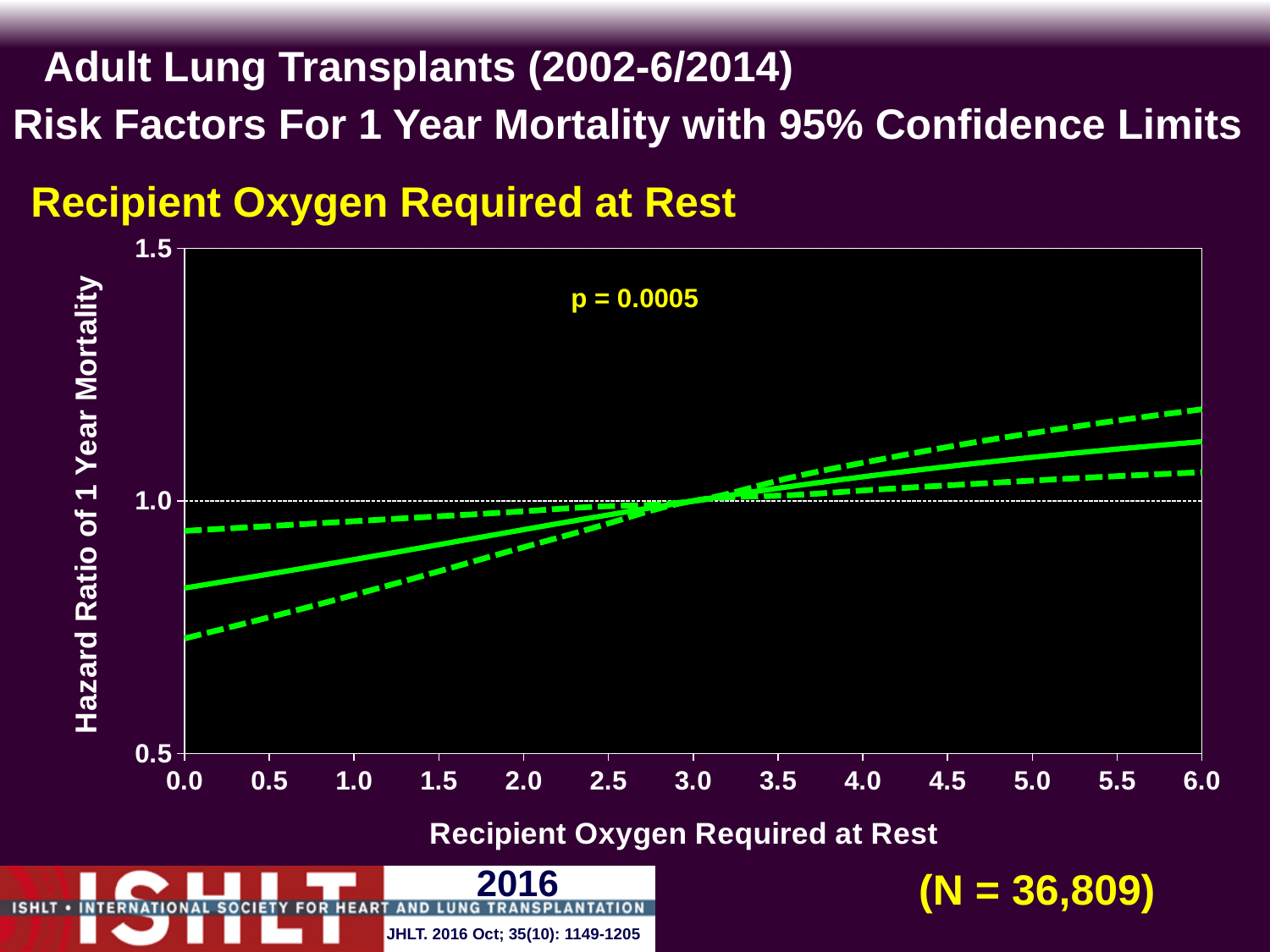
Does the solid hazard ratio line rise or fall as Recipient Oxygen Required at Rest increases from 0.0 to 6.0? rise Is the hazard ratio (solid line) at a Recipient Oxygen Required at Rest of 6.0 greater or less than 1.0? greater How many lines are plotted on the chart (solid and dashed combined)? 3 What p-value is printed on the chart? p = 0.0005 Is the upper dashed confidence limit at a Recipient Oxygen Required at Rest of 6.0 greater or less than 1.0? greater Is the upper dashed confidence limit at a Recipient Oxygen Required at Rest of 6.0 greater or less than 1.5? less What kind of chart is shown on the slide? line chart How many tick labels are shown on the x axis of the chart? 13 What sample size (N) is shown on the slide? N = 36,809